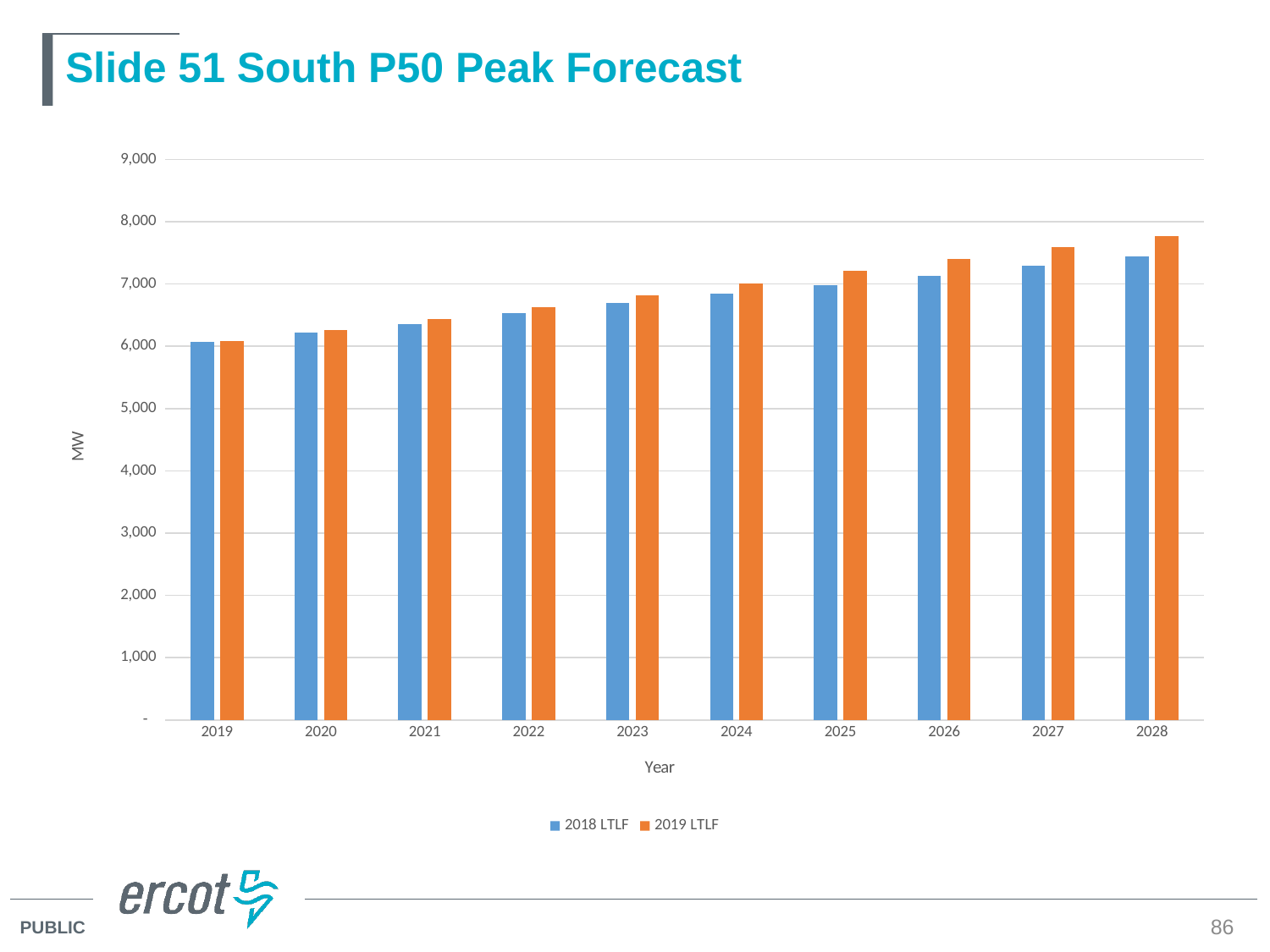
How many series does the legend list? 2 Is the 2018 LTLF value for 2028 greater or less than 7,000? greater Is the 2018 LTLF value for 2019 greater or less than 7,000? less Is the 2019 LTLF value for 2028 greater or less than 7,000? greater For 2028, which series has the larger value, 2018 LTLF or 2019 LTLF? 2019 LTLF Do the 2019 LTLF values rise or fall from 2019 to 2028? Rise What is the label on the y axis? MW Which year has the highest 2019 LTLF value? 2028 How many years are shown on the x axis? 10 What kind of chart is shown on the slide? Bar chart Which year has the lowest 2018 LTLF value? 2019